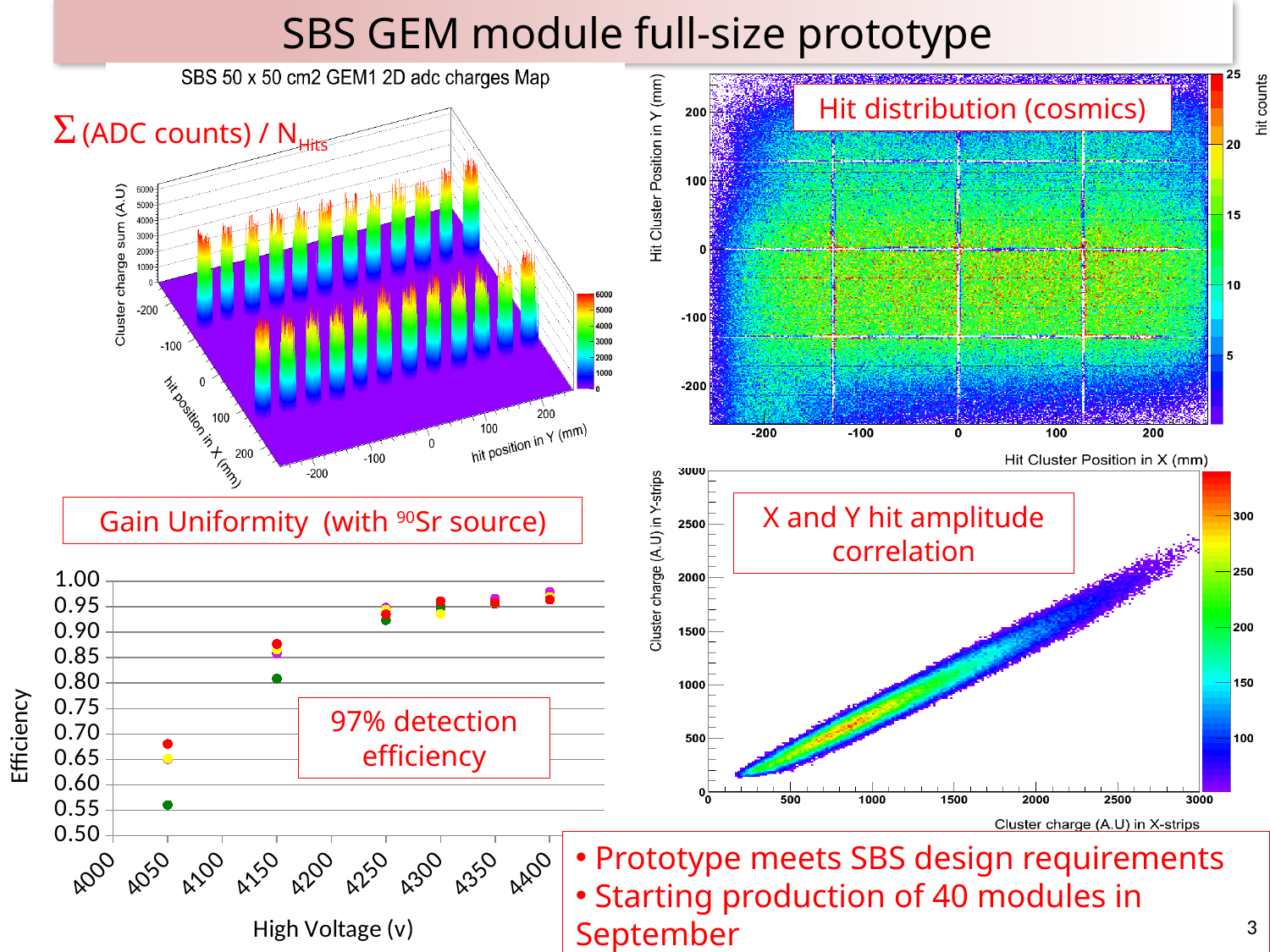
In the efficiency versus high voltage chart at the bottom left, is the green point at 4150 V greater or less than 0.85? less In the efficiency versus high voltage chart at the bottom left, is the green point at 4050 V greater or less than 0.60? less In the efficiency versus high voltage chart at the bottom left, are the points at 4400 V greater or less than 0.95? greater In the efficiency versus high voltage chart at the bottom left, does efficiency rise or fall as the high voltage increases? rise In the 'X and Y hit amplitude correlation' chart at the bottom right, does the cluster charge in Y-strips rise or fall as the cluster charge in X-strips increases? rise What is the x-axis label of the efficiency chart at the bottom left? High Voltage (v) In the efficiency versus high voltage chart at the bottom left, at 4050 V which point is higher, the red one or the green one? red What is the title of the 3D chart at the top left of the slide? SBS 50 x 50 cm2 GEM1 2D adc charges Map What kind of chart is the efficiency versus high voltage plot at the bottom left? scatter plot In the efficiency versus high voltage chart at the bottom left, how many distinct high-voltage settings have plotted points? 6